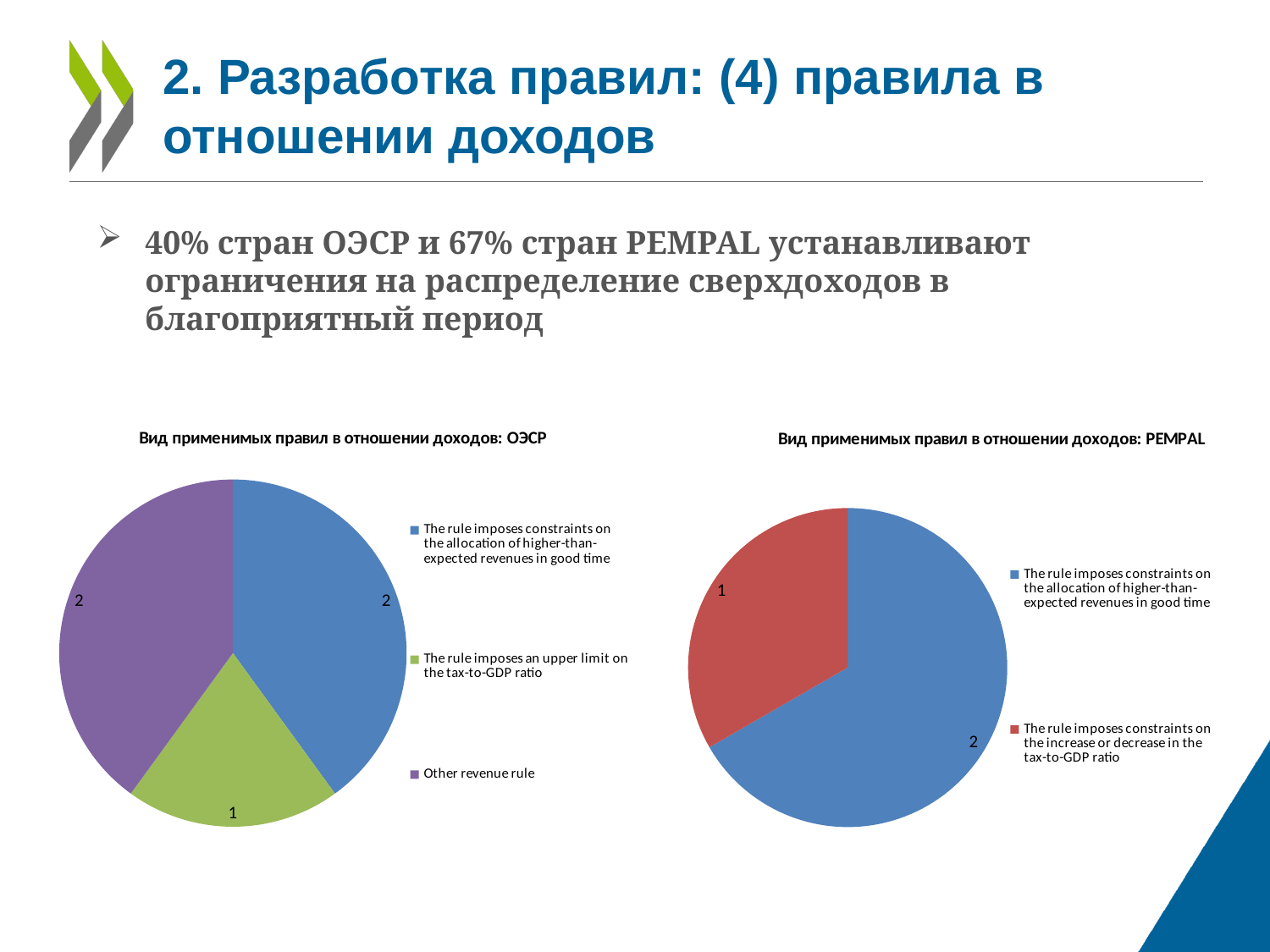
In the chart titled "Вид применимых правил в отношении доходов: PEMPAL", what is the value for "The rule imposes constraints on the allocation of higher-than-expected revenues in good time"? 2 In the chart titled "Вид применимых правил в отношении доходов: ОЭСР", what is the value for "Other revenue rule"? 2 In the chart titled "Вид применимых правил в отношении доходов: ОЭСР", what is the value for "The rule imposes an upper limit on the tax-to-GDP ratio"? 1 In the chart titled "Вид применимых правил в отношении доходов: PEMPAL", which category has the highest value? The rule imposes constraints on the allocation of higher-than-expected revenues in good time In the chart titled "Вид применимых правил в отношении доходов: PEMPAL", how many slices does the pie have? 2 What type of chart is the chart titled "Вид применимых правил в отношении доходов: ОЭСР"? pie chart In the chart titled "Вид применимых правил в отношении доходов: PEMPAL", what colour is the slice for "The rule imposes constraints on the increase or decrease in the tax-to-GDP ratio"? red In the chart titled "Вид применимых правил в отношении доходов: ОЭСР", how many categories does the legend list? 3 In the chart titled "Вид применимых правил в отношении доходов: ОЭСР", which category has the lowest value? The rule imposes an upper limit on the tax-to-GDP ratio In the chart titled "Вид применимых правил в отношении доходов: PEMPAL", what is the value for "The rule imposes constraints on the increase or decrease in the tax-to-GDP ratio"? 1 In the chart titled "Вид применимых правил в отношении доходов: ОЭСР", what share of the pie does "The rule imposes constraints on the allocation of higher-than-expected revenues in good time" represent? 40% In the chart titled "Вид применимых правил в отношении доходов: ОЭСР", what is the difference between the value for "Other revenue rule" and the value for "The rule imposes an upper limit on the tax-to-GDP ratio"? 1